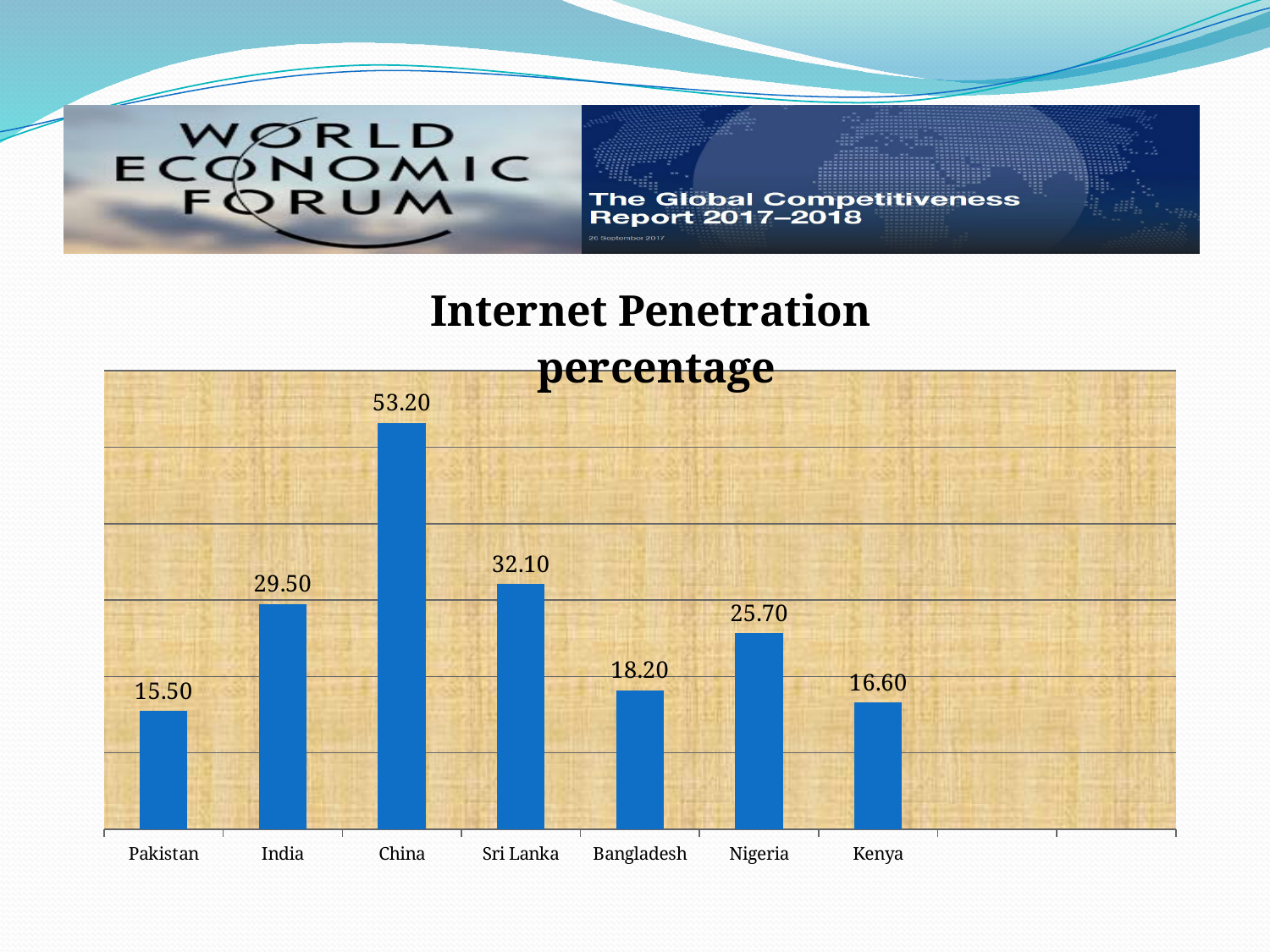
Which country has the highest internet penetration percentage? China Which has a higher value, Sri Lanka or Nigeria? Sri Lanka What is the internet penetration percentage for China? 53.20 What is the internet penetration percentage for Pakistan? 15.50 What kind of chart is shown on the slide? Bar chart Which country has the lowest internet penetration percentage? Pakistan What is the title of the chart? Internet Penetration percentage What is the value shown for Sri Lanka? 32.10 How many countries are shown in the chart? 7 What is the difference between the values for Bangladesh and Kenya? 1.60 What is the difference between the values for China and India? 23.70 What is the value shown for Nigeria? 25.70